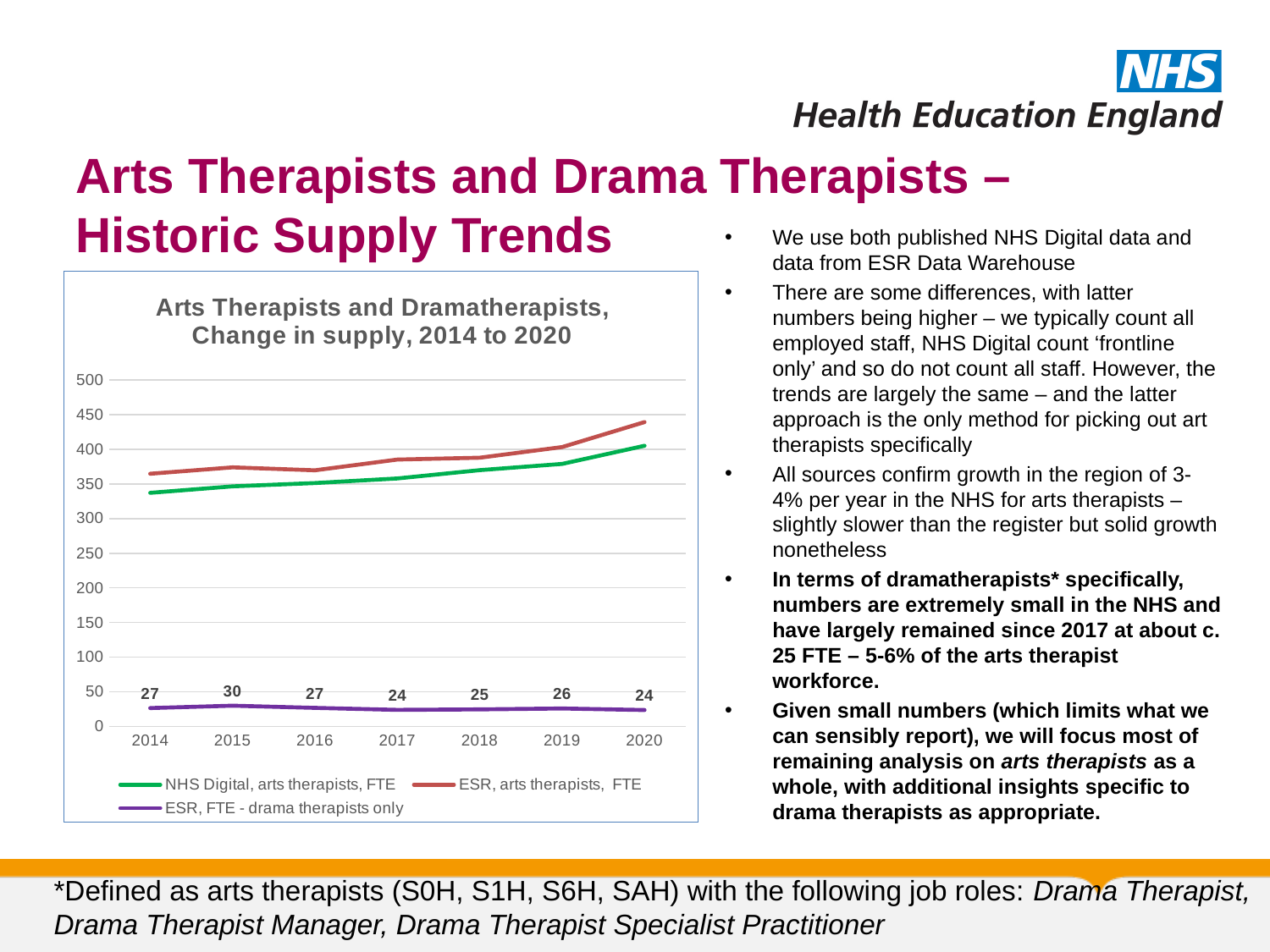
What is the value for ESR, FTE - drama therapists only in 2015? 30 What is the value for ESR, FTE - drama therapists only in 2020? 24 What is the difference between the ESR, FTE - drama therapists only values for 2015 and 2020? 6 In which year is the ESR, FTE - drama therapists only value highest? 2015 How many series does the chart legend list? 3 What kind of chart is shown on the slide? line chart Which year has the larger ESR, FTE - drama therapists only value, 2016 or 2018? 2016 How many years are plotted along the x axis of the chart? 7 Is the value for ESR, arts therapists, FTE in 2020 greater or less than 400? greater What is the lowest value shown for ESR, FTE - drama therapists only? 24 Does the NHS Digital, arts therapists, FTE line rise or fall from 2014 to 2020? rise Is the value for NHS Digital, arts therapists, FTE in 2014 greater or less than 350? less